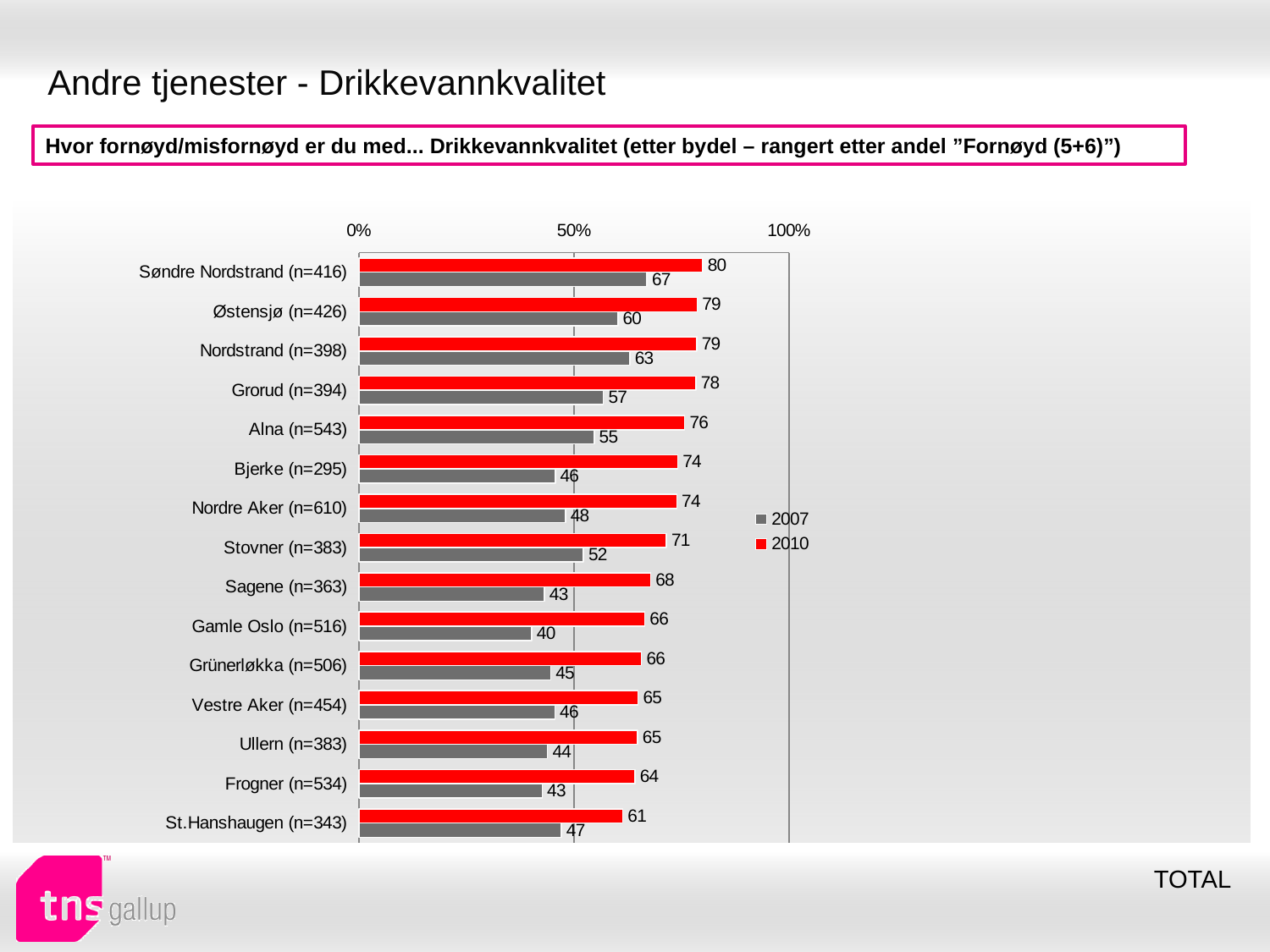
What is the 2007 value for Nordstrand (n=398)? 63 Which colour represents the 2010 series? Red What is the 2010 value for Søndre Nordstrand (n=416)? 80 What kind of chart is shown on the slide? Bar chart What is the difference between the 2010 and 2007 values for Bjerke (n=295)? 28 Which district has the lowest 2007 value? Gamle Oslo (n=516) Is the 2010 value for St.Hanshaugen (n=343) greater or less than 50%? greater Which district has the highest 2010 value? Søndre Nordstrand (n=416) What is the 2007 value for Gamle Oslo (n=516)? 40 How many series does the legend list? 2 How many districts are shown on the chart? 15 Which is larger: the 2007 value for Stovner (n=383) or the 2007 value for Sagene (n=363)? Stovner (n=383)